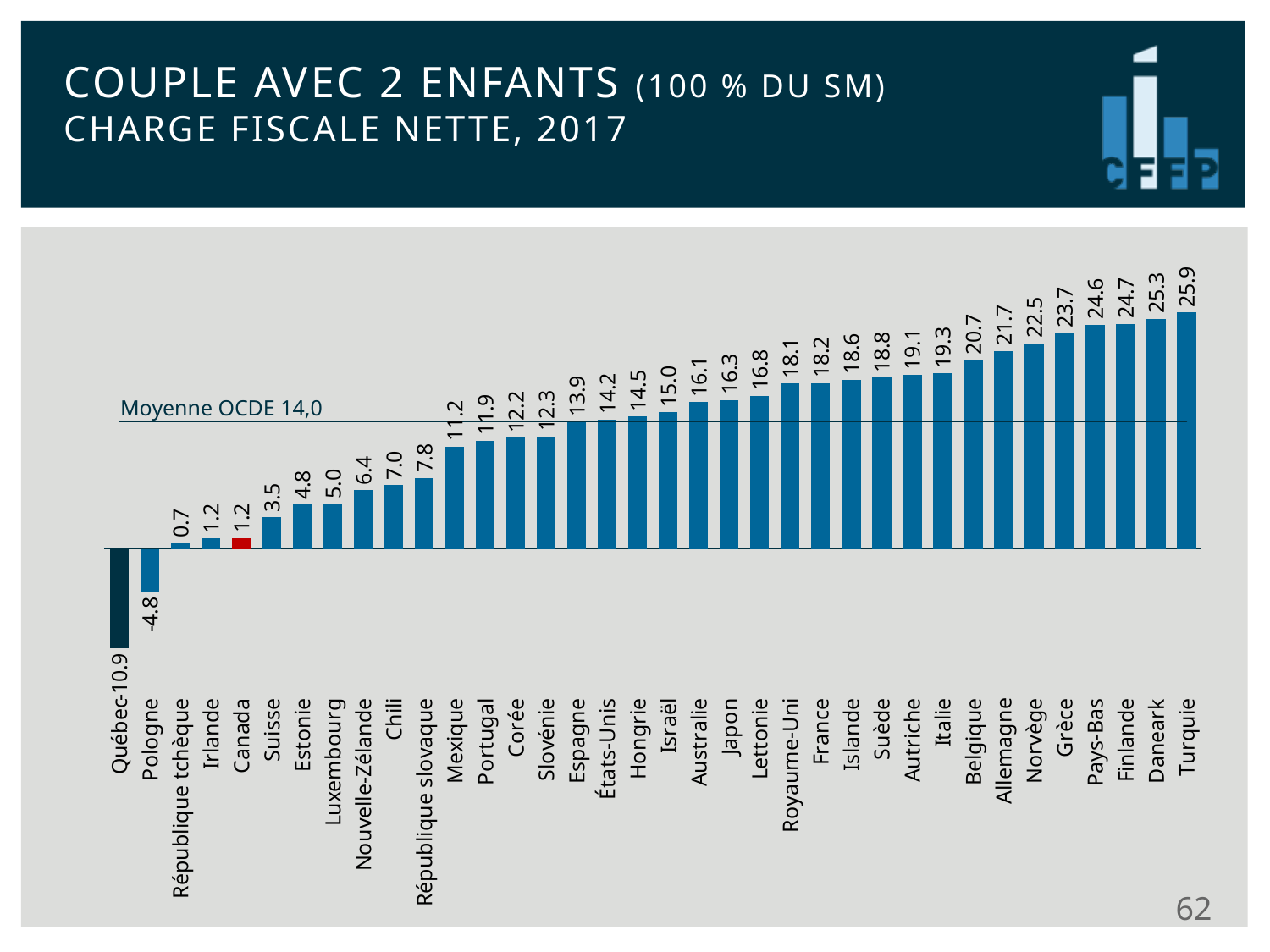
What is the value for Québec? -10.9 What is the difference between the values for Turquie and Québec? 36.8 What is the value for Canada? 1.2 What is the difference between the values for Allemagne and Suisse? 18.2 How many countries or regions are shown in the chart? 36 What type of chart is shown on the slide? Bar chart Which is larger, the value for Pologne or the value for Irlande? Irlande Which category has the lowest value? Québec What is the OECD average (Moyenne OCDE) indicated by the horizontal line? 14,0 What is the value for France? 18.2 Which country has the highest value? Turquie Which is larger, the value for Mexique or the value for Chili? Mexique